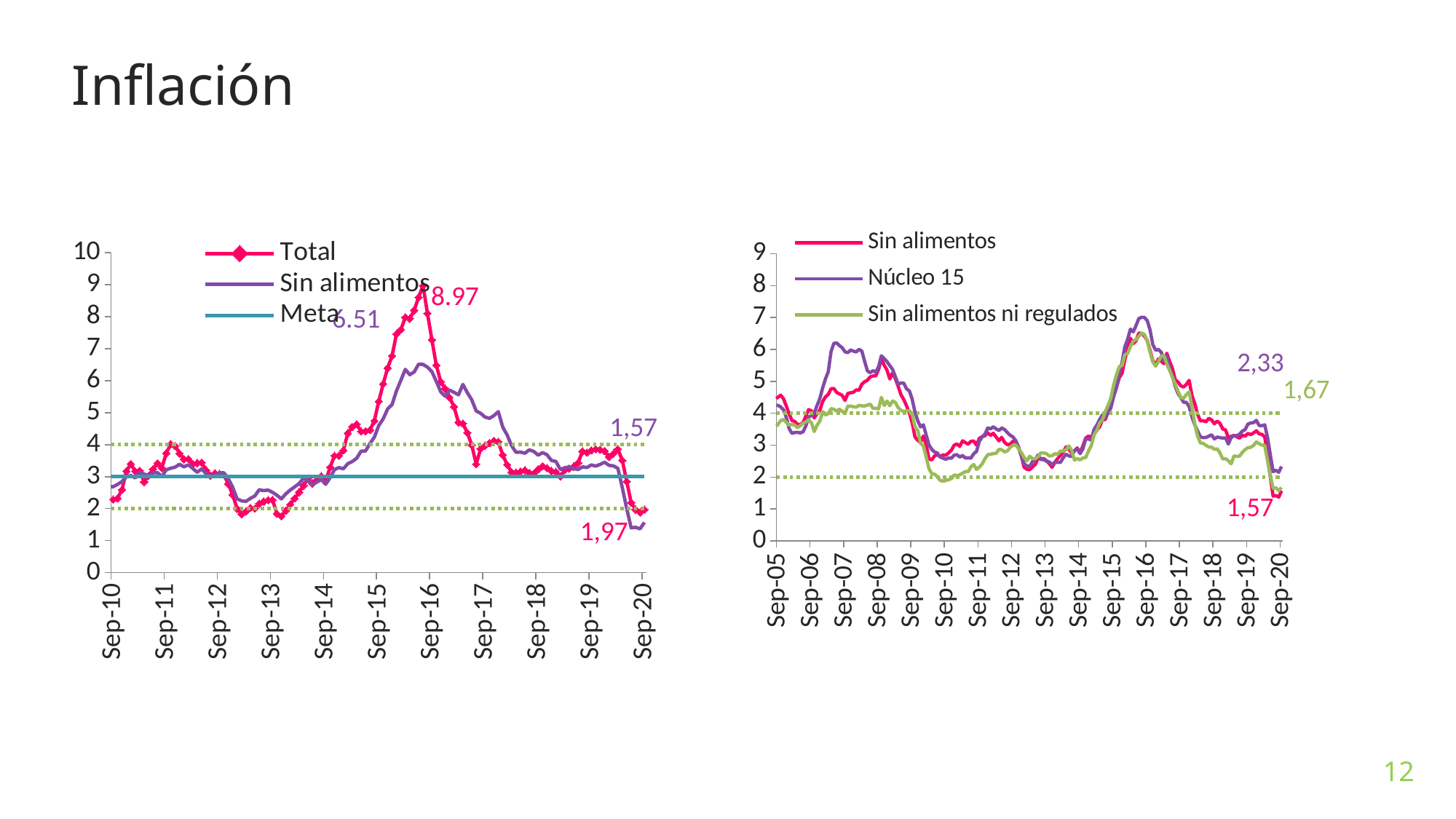
On the left chart, at what level is the Meta line drawn? 3 On the right chart, what is the final value labelled for the Núcleo 15 series at Sep-20? 2,33 On the right chart, how many series does the legend list? 3 On the left chart, what is the final value labelled for the Total series at Sep-20? 1,97 On the right chart, what is the final value labelled for the Sin alimentos ni regulados series at Sep-20? 1,67 On the left chart, what is the difference between the labelled peak of Total (8.97) and the labelled peak of Sin alimentos (6.51)? 2.46 What kind of chart is the right chart? Line chart On the left chart, what is the final value labelled for the Sin alimentos series at Sep-20? 1,57 On the left chart, what is the peak value labelled for the Total series? 8.97 On the left chart, how many series does the legend list? 3 On the left chart, which series has the higher labelled peak, Total or Sin alimentos? Total On the left chart, what is the peak value labelled for the Sin alimentos series? 6.51